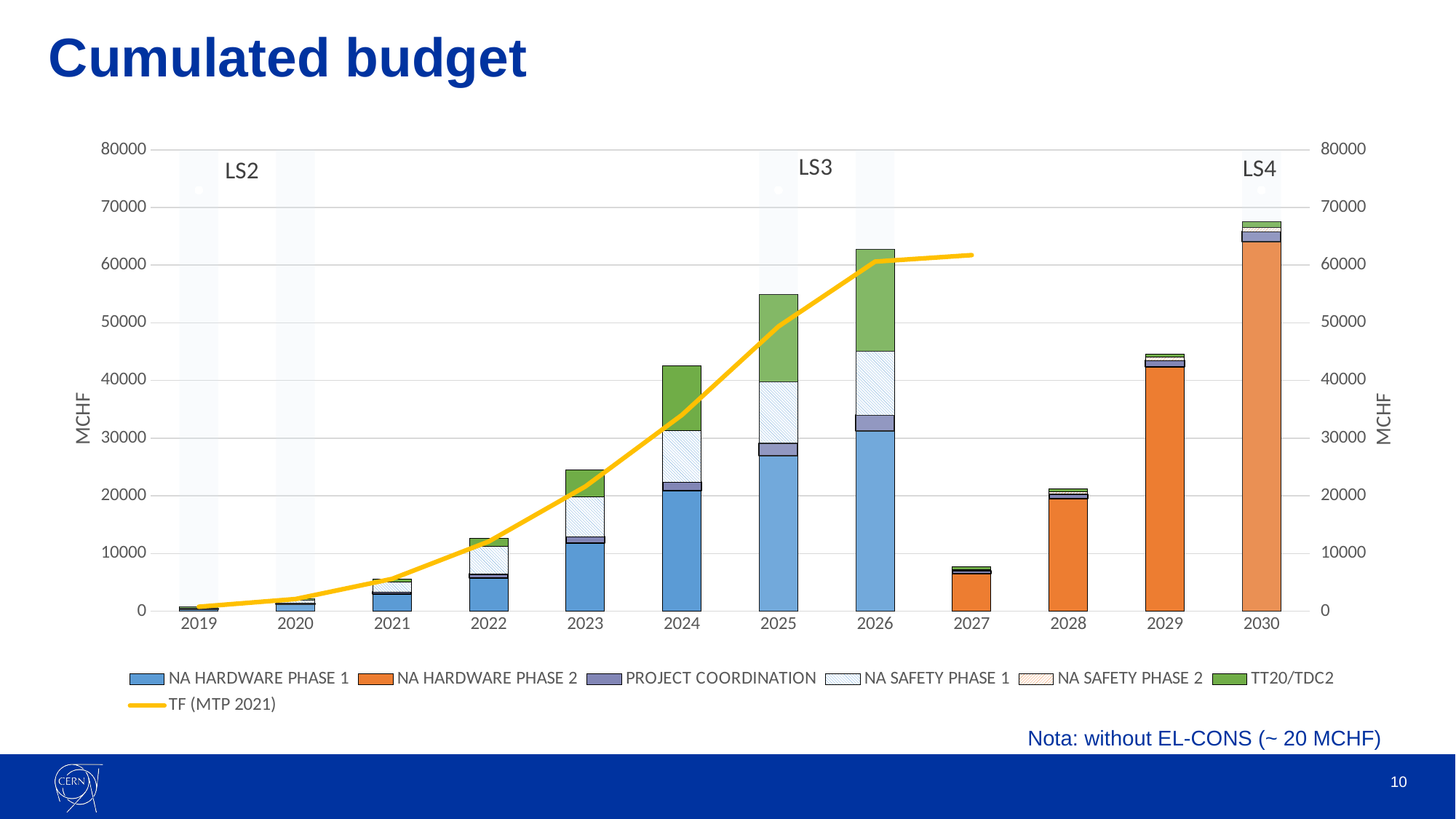
How many years are shown on the x axis? 12 What is the title of the chart? Cumulated budget Which year has the lowest total bar? 2019 What is the name of the line series in the legend? TF (MTP 2021) Is the total bar for 2030 greater or less than 60000? greater What kind of chart is shown on the slide? Stacked bar chart with a line Which year has the highest total bar? 2030 Is the total bar for 2025 greater or less than 50000? greater Do the total bars rise or fall from 2019 to 2026? rise Is the total bar for 2027 greater or less than 10000? less Which year has the larger total bar, 2025 or 2026? 2026 How many series does the legend list? 7